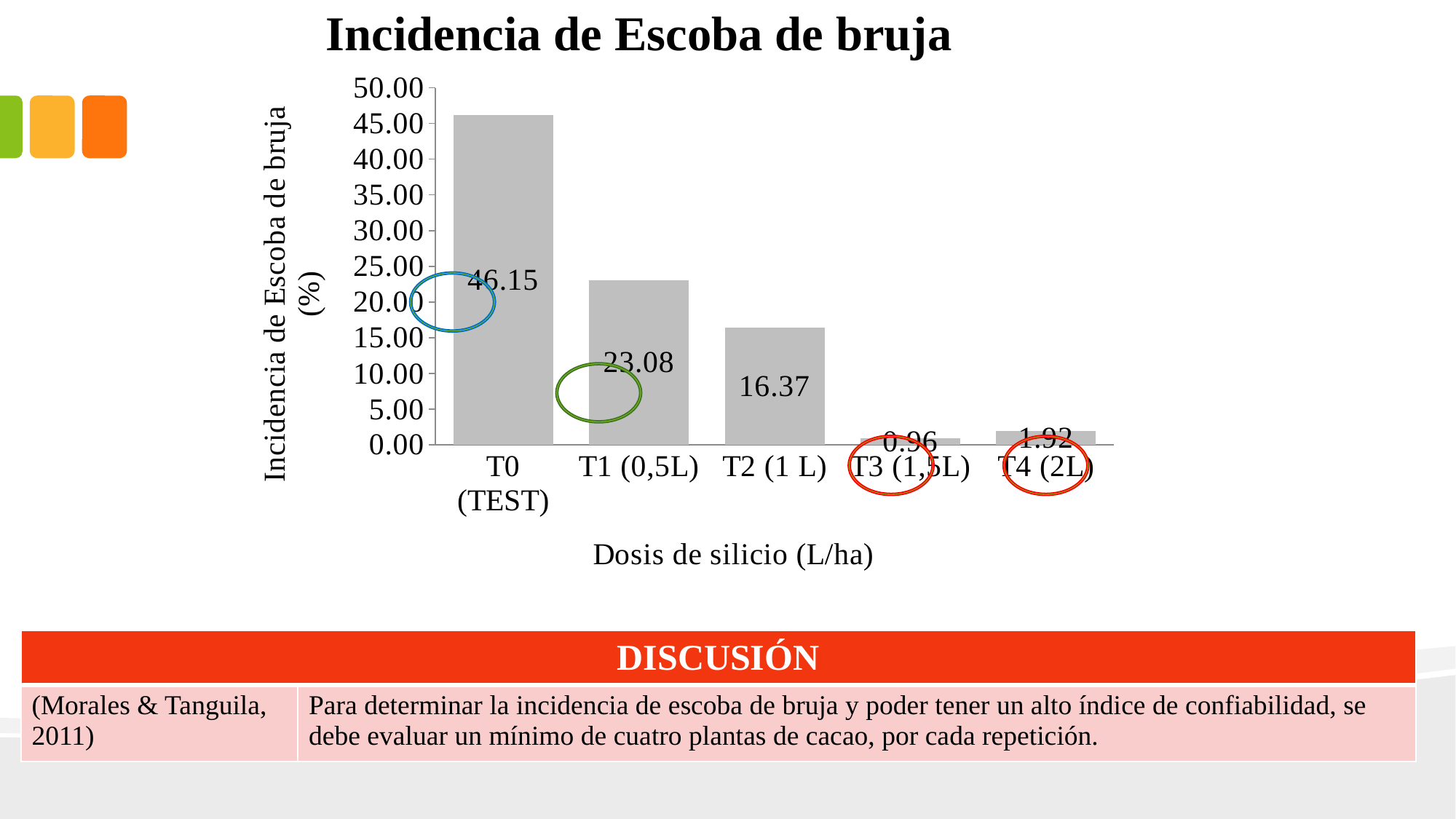
How many categories are shown on the x axis? 5 Which category has the highest incidence? T0 (TEST) What is the value for T0 (TEST)? 46.15 What is the value for T3 (1,5L)? 0.96 What is the value for T1 (0,5L)? 23.08 What is the x-axis label of the chart? Dosis de silicio (L/ha) Which category has the lowest incidence? T3 (1,5L) What is the value for T4 (2L)? 1.92 What is the value for T2 (1 L)? 16.37 Which is larger, the value for T2 (1 L) or the value for T4 (2L)? T2 (1 L) What is the difference between the values for T0 (TEST) and T1 (0,5L)? 23.07 What kind of chart is this? Bar chart